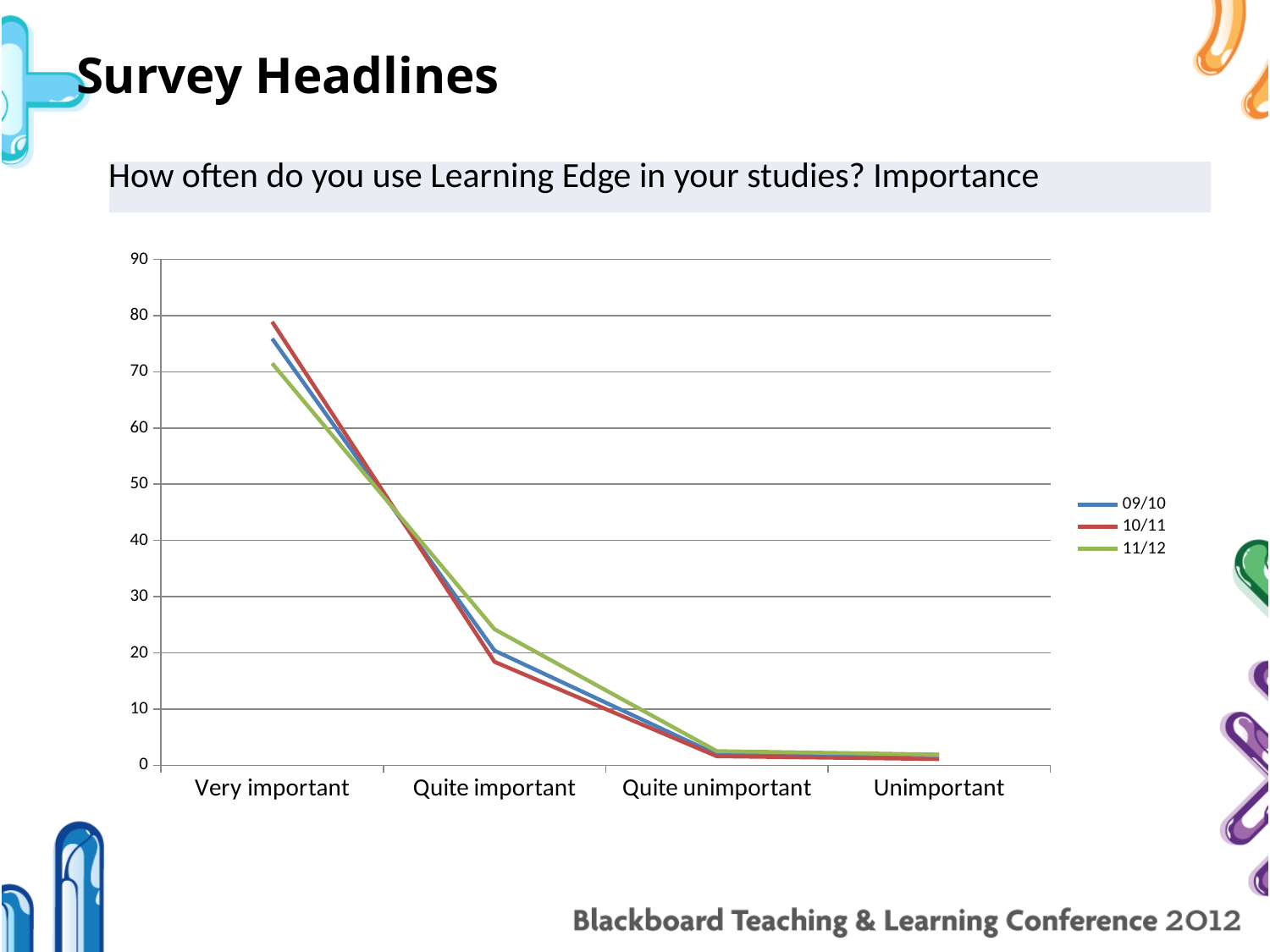
For the Quite important category, which series has the larger value, 11/12 or 10/11? 11/12 How many categories are shown on the x axis? 4 Do the values rise or fall along the x axis from Very important to Unimportant? fall Which category has the lowest value for the 10/11 series? Unimportant Is the value for Quite unimportant in the 09/10 series greater or less than 10? less What kind of chart is shown on the slide? line chart What are the three series listed in the legend? 09/10, 10/11, 11/12 How many series does the legend list? 3 For the Very important category, which series has the larger value, 10/11 or 11/12? 10/11 Which category has the highest value for the 10/11 series? Very important Is the value for Quite important in the 11/12 series greater or less than 30? less Is the value for Very important in the 10/11 series greater or less than 70? greater